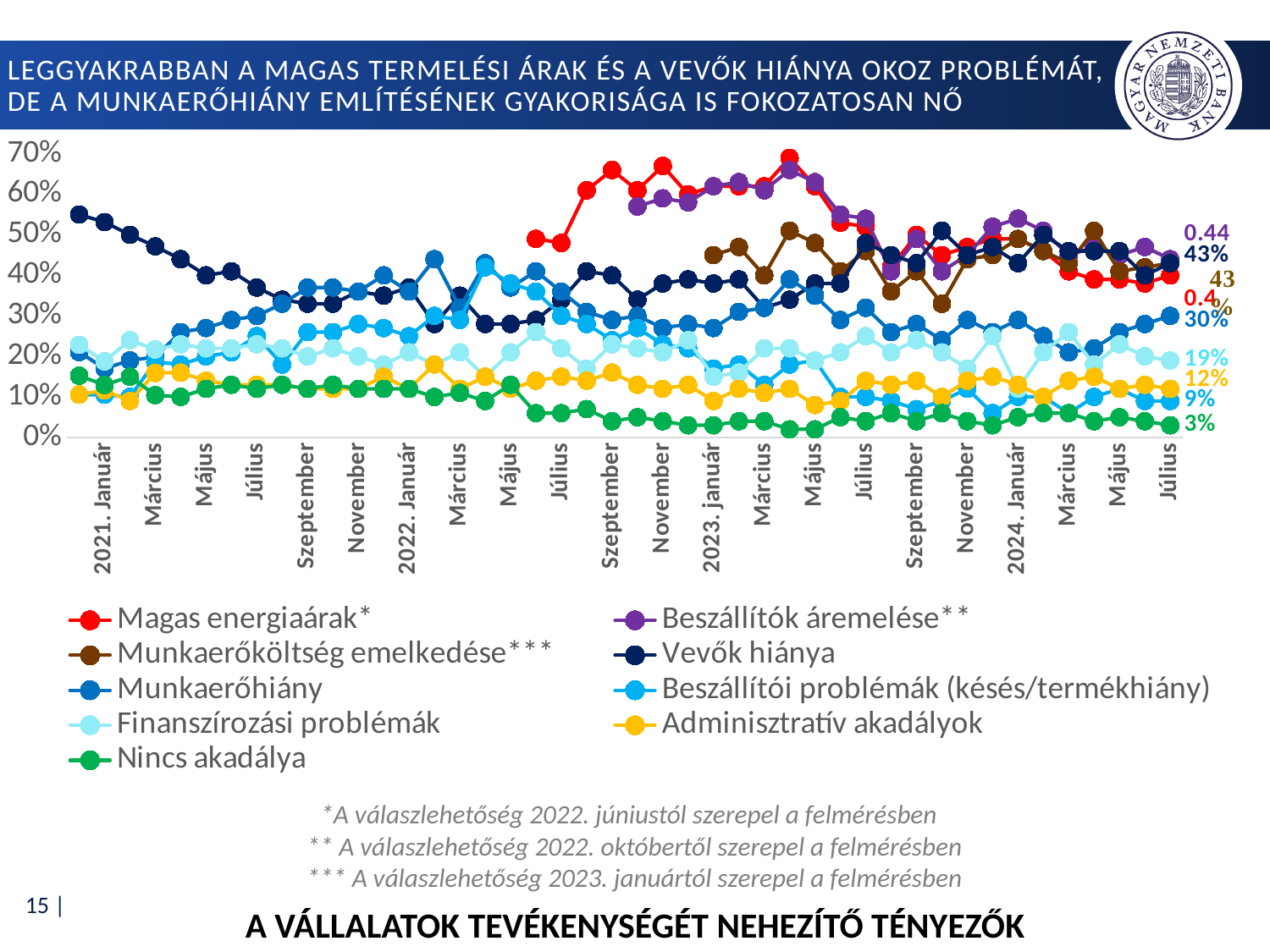
What is the last labelled value for the series 'Vevők hiánya'? 43% What is the difference between the final labelled values of 'Vevők hiánya' and 'Munkaerőhiány'? 13 percentage points What is the last labelled value for the series 'Finanszírozási problémák'? 19% Which series has the lowest labelled value at the end of the chart? Nincs akadálya What is the last labelled value for the series 'Nincs akadálya'? 3% What is the last labelled value for the series 'Munkaerőhiány'? 30% How many series does the legend list? 9 What is the last labelled value for the series 'Beszállítói problémák (késés/termékhiány)'? 9% Is the value for 'Vevők hiánya' in 2021. Január greater or less than 50%? greater Does the 'Vevők hiánya' series rise or fall over the course of 2021? fall At the end of the chart, which is larger: 'Munkaerőhiány' or 'Finanszírozási problémák'? Munkaerőhiány What kind of chart is shown on the slide? line chart